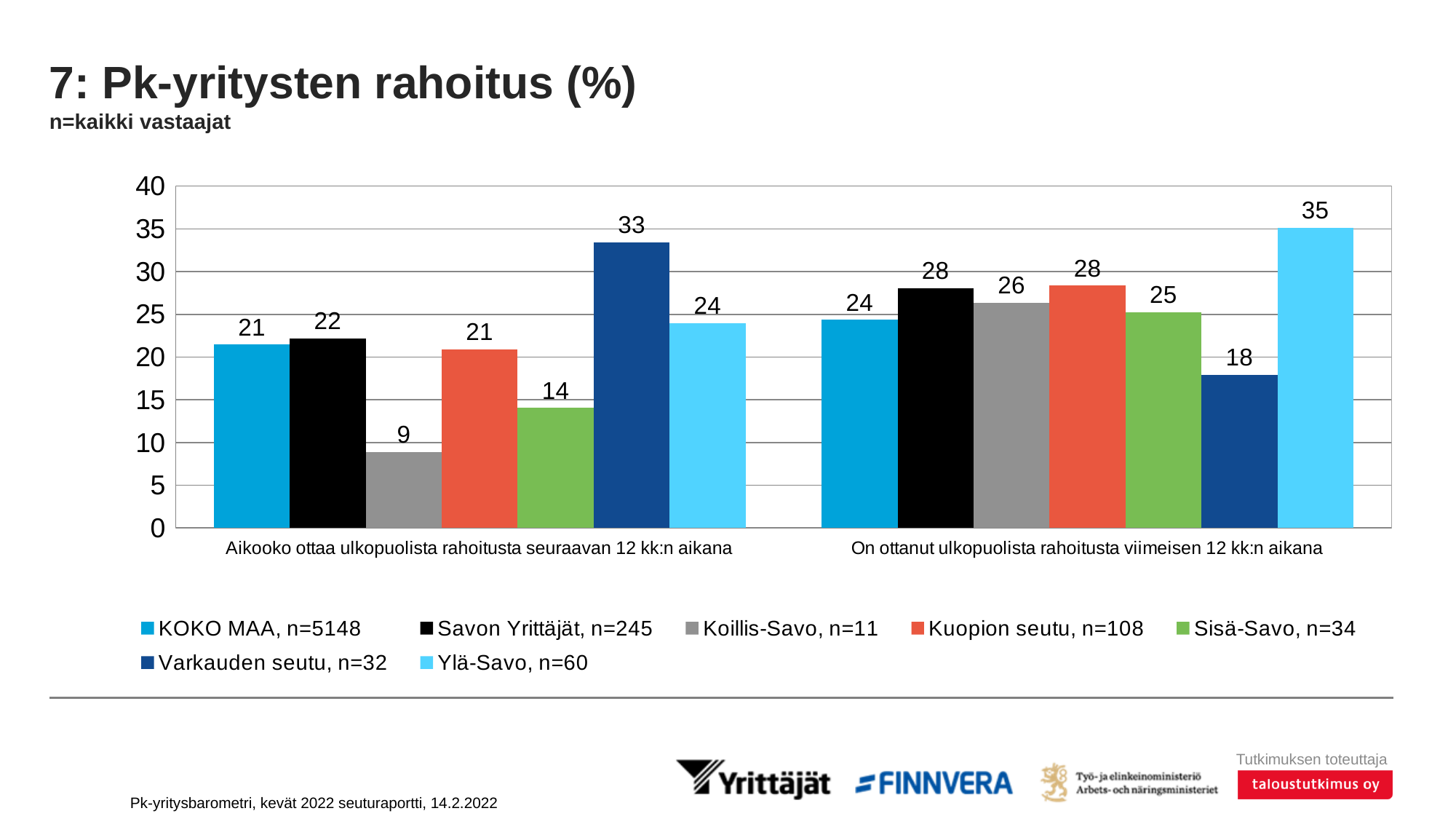
Is the value for Ylä-Savo in the category "On ottanut ulkopuolista rahoitusta viimeisen 12 kk:n aikana" greater or less than 30? greater How many series does the legend list? 7 Which series has the lowest value in the category "Aikooko ottaa ulkopuolista rahoitusta seuraavan 12 kk:n aikana"? Koillis-Savo, n=11 Which series has the highest value in the category "On ottanut ulkopuolista rahoitusta viimeisen 12 kk:n aikana"? Ylä-Savo, n=60 What is the value for Varkauden seutu in the category "Aikooko ottaa ulkopuolista rahoitusta seuraavan 12 kk:n aikana"? 33 What is the difference between the Varkauden seutu value and the Sisä-Savo value in the category "Aikooko ottaa ulkopuolista rahoitusta seuraavan 12 kk:n aikana"? 19 What is the value for KOKO MAA in the category "On ottanut ulkopuolista rahoitusta viimeisen 12 kk:n aikana"? 24 What is the value for Ylä-Savo in the category "On ottanut ulkopuolista rahoitusta viimeisen 12 kk:n aikana"? 35 What kind of chart is shown on the slide? bar chart How many categories are shown on the x axis? 2 What is the value for Koillis-Savo in the category "Aikooko ottaa ulkopuolista rahoitusta seuraavan 12 kk:n aikana"? 9 Which is larger for Varkauden seutu: the value for "Aikooko ottaa ulkopuolista rahoitusta seuraavan 12 kk:n aikana" or the value for "On ottanut ulkopuolista rahoitusta viimeisen 12 kk:n aikana"? Aikooko ottaa ulkopuolista rahoitusta seuraavan 12 kk:n aikana